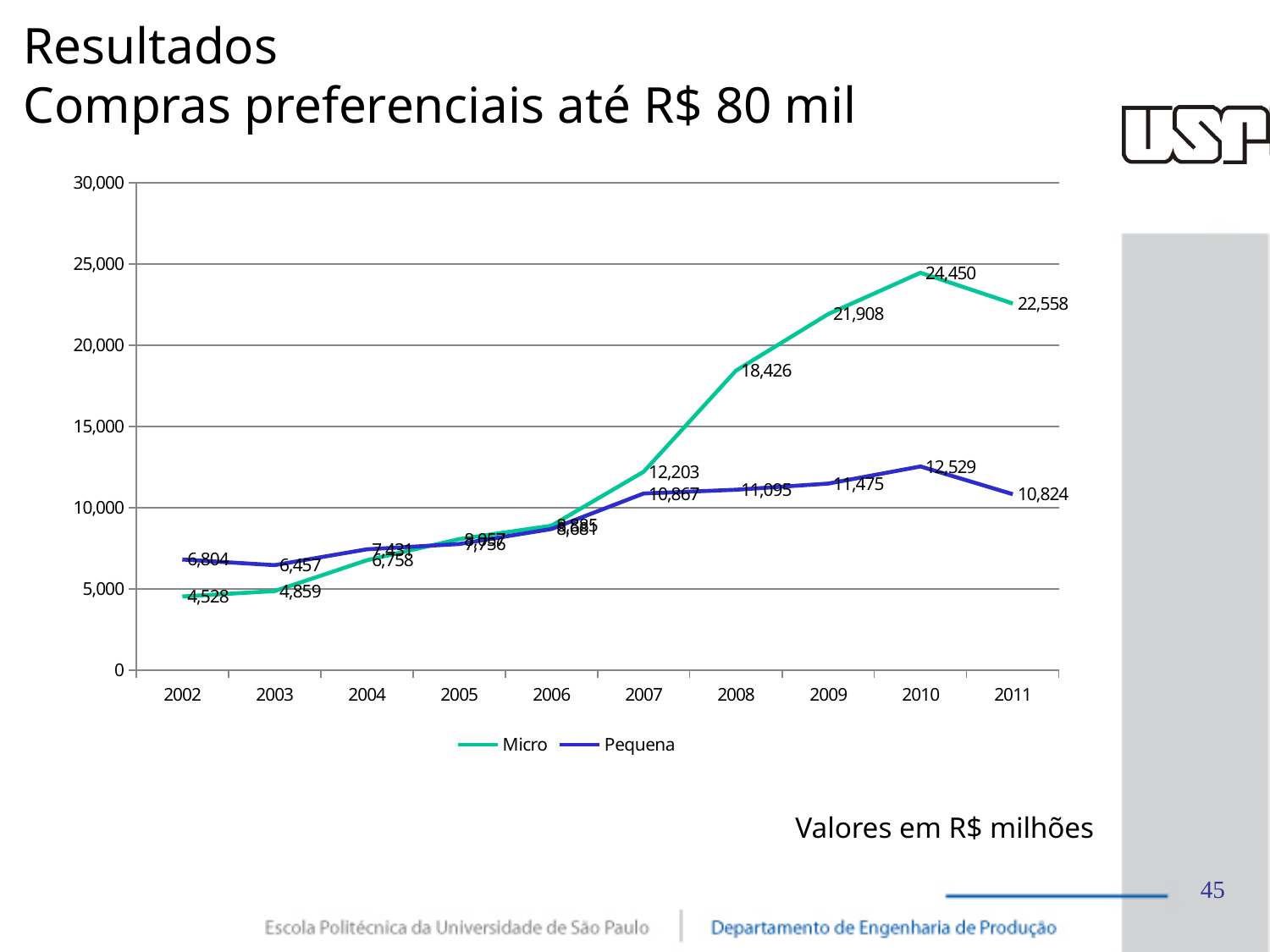
What kind of chart is shown on the slide? line chart What is the value for Micro in 2010? 24,450 In which year does the Pequena series reach its highest value? 2010 What is the difference between the Micro values for 2010 and 2011? 1,892 In which year does the Micro series reach its highest value? 2010 How many series does the legend list? 2 What is the value for Pequena in 2011? 10,824 What are the two series named in the legend? Micro and Pequena How many years are plotted along the x axis? 10 Is the value for Micro in 2009 greater or less than 20,000? greater In 2002, which series has the larger value, Micro or Pequena? Pequena What is the value for Micro in 2008? 18,426